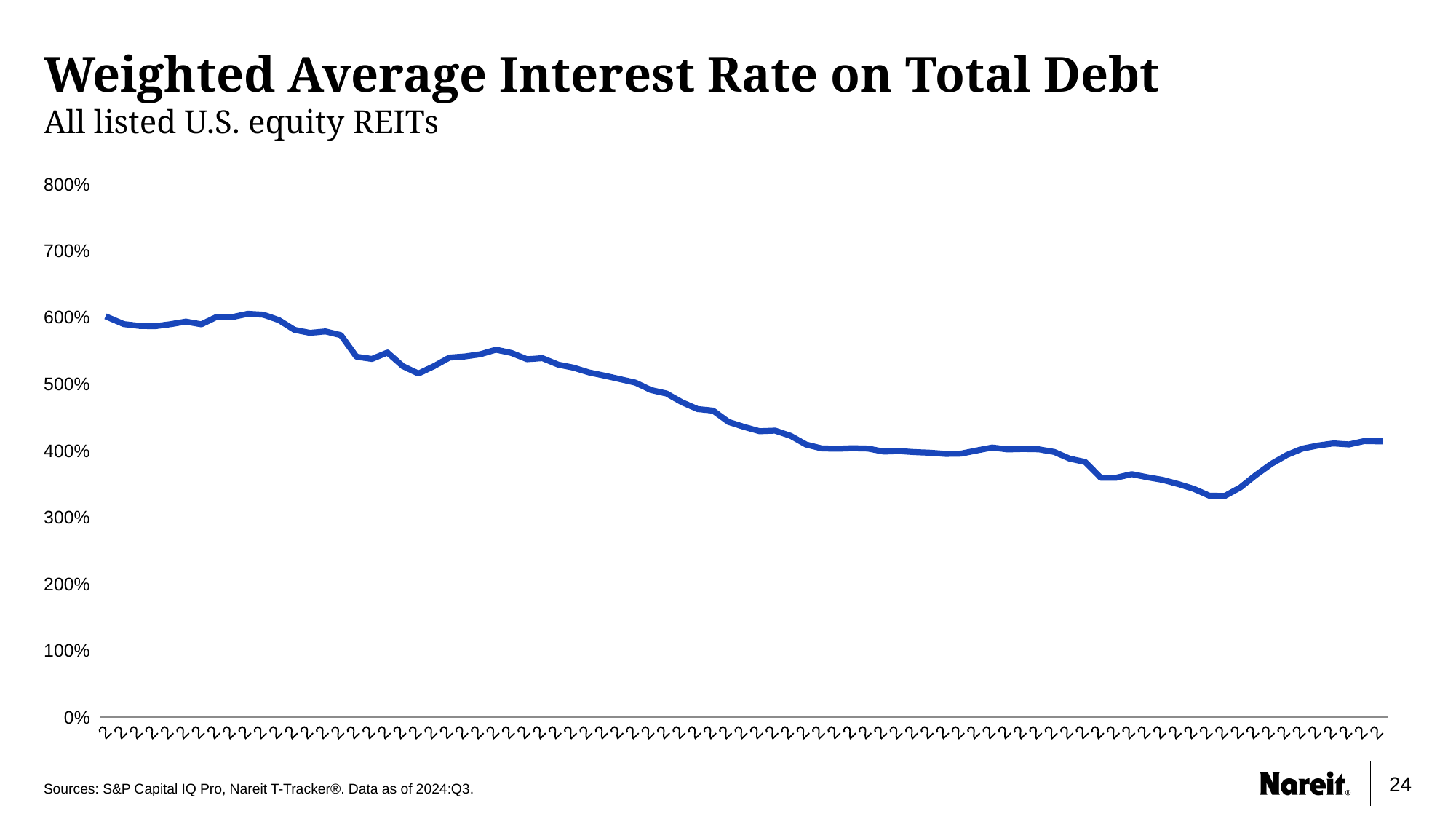
Is the value at the leftmost point of the line greater or less than 500%? greater What kind of chart is shown on the slide? line chart Overall, does the plotted line rise or fall from left to right across the chart? fall Is the highest point of the line greater or less than 700%? less What is the highest value labelled on the vertical axis? 800% Is the lowest point of the line greater or less than 300%? greater What is the title of the chart on the slide? Weighted Average Interest Rate on Total Debt Which group of companies does the chart's subtitle say the data covers? All listed U.S. equity REITs Which is larger, the value at the leftmost point of the line or the value at the rightmost point? the leftmost point